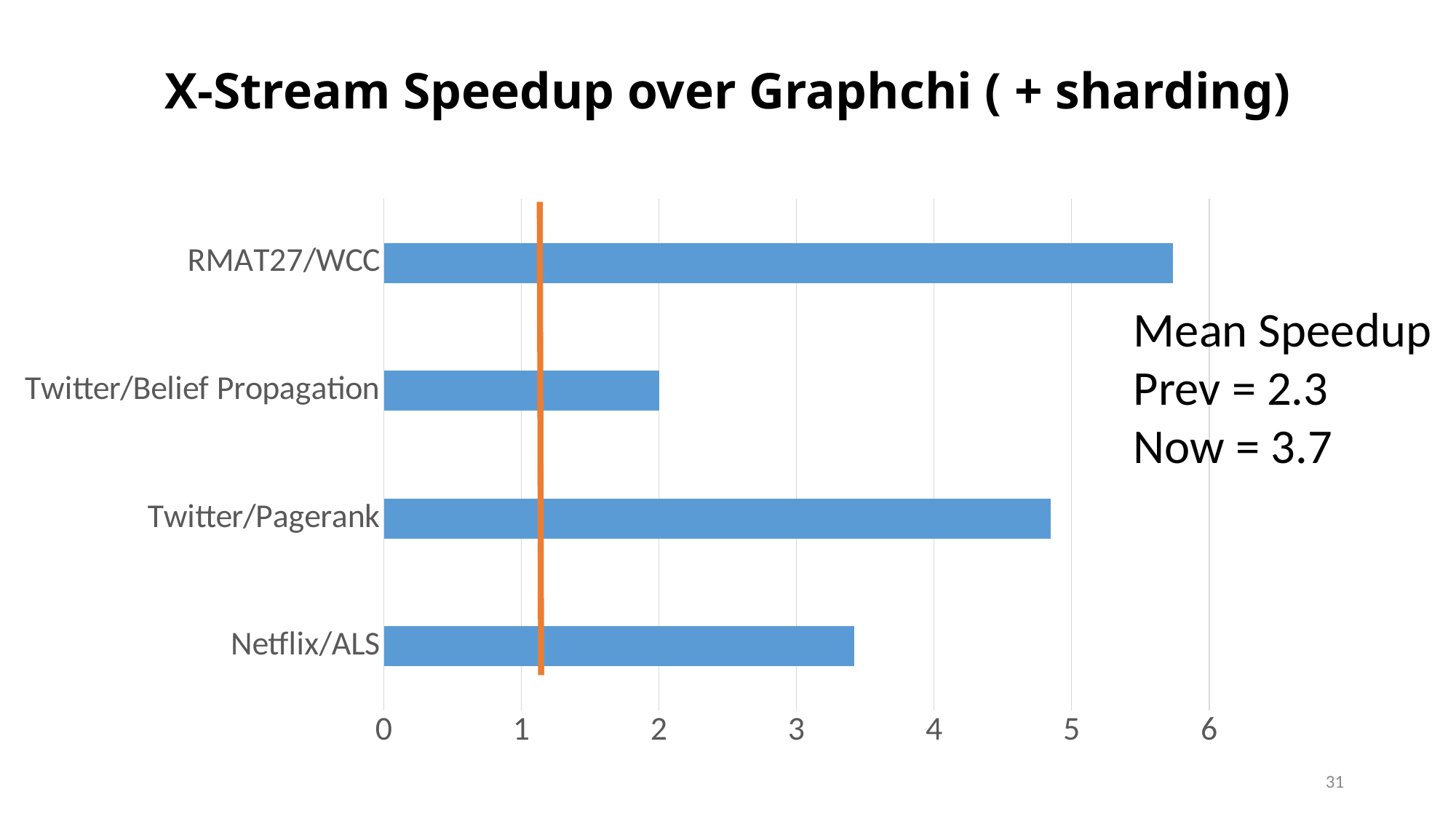
Which category has the lowest speedup? Twitter/Belief Propagation Is the value for RMAT27/WCC greater or less than 5? greater According to the text on the slide, what is the current mean speedup (Now)? 3.7 How many categories are plotted in the chart? 4 What is the title of the chart? X-Stream Speedup over Graphchi ( + sharding) Which category has the highest speedup? RMAT27/WCC Which has a larger speedup, Twitter/Pagerank or Netflix/ALS? Twitter/Pagerank What kind of chart is shown on the slide? bar chart Is the value for Twitter/Pagerank greater or less than 5? less Is the value for Twitter/Belief Propagation greater or less than 3? less Which has a larger speedup, RMAT27/WCC or Twitter/Pagerank? RMAT27/WCC